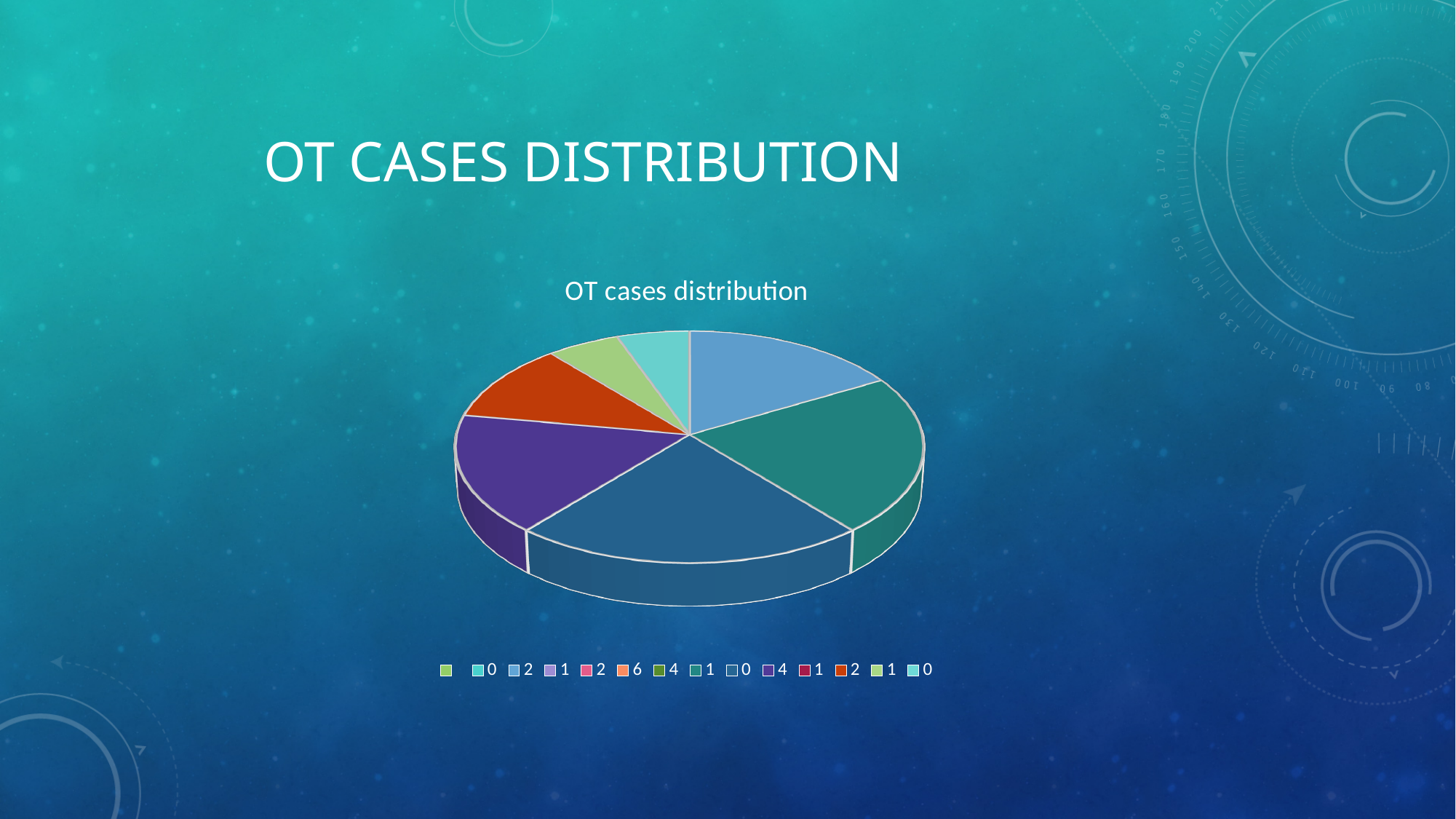
What kind of chart is shown on the slide? pie chart What is the largest number that appears as a legend label? 6 Which slice is larger, the dark blue slice at the bottom or the cyan slice at the top? the dark blue slice Which slice is larger, the light blue slice at the top right or the light green slice at the top left? the light blue slice Which slice is larger, the purple slice or the red-orange slice? the purple slice How many slices are visible in the pie chart? 7 What is the title of the chart? OT cases distribution